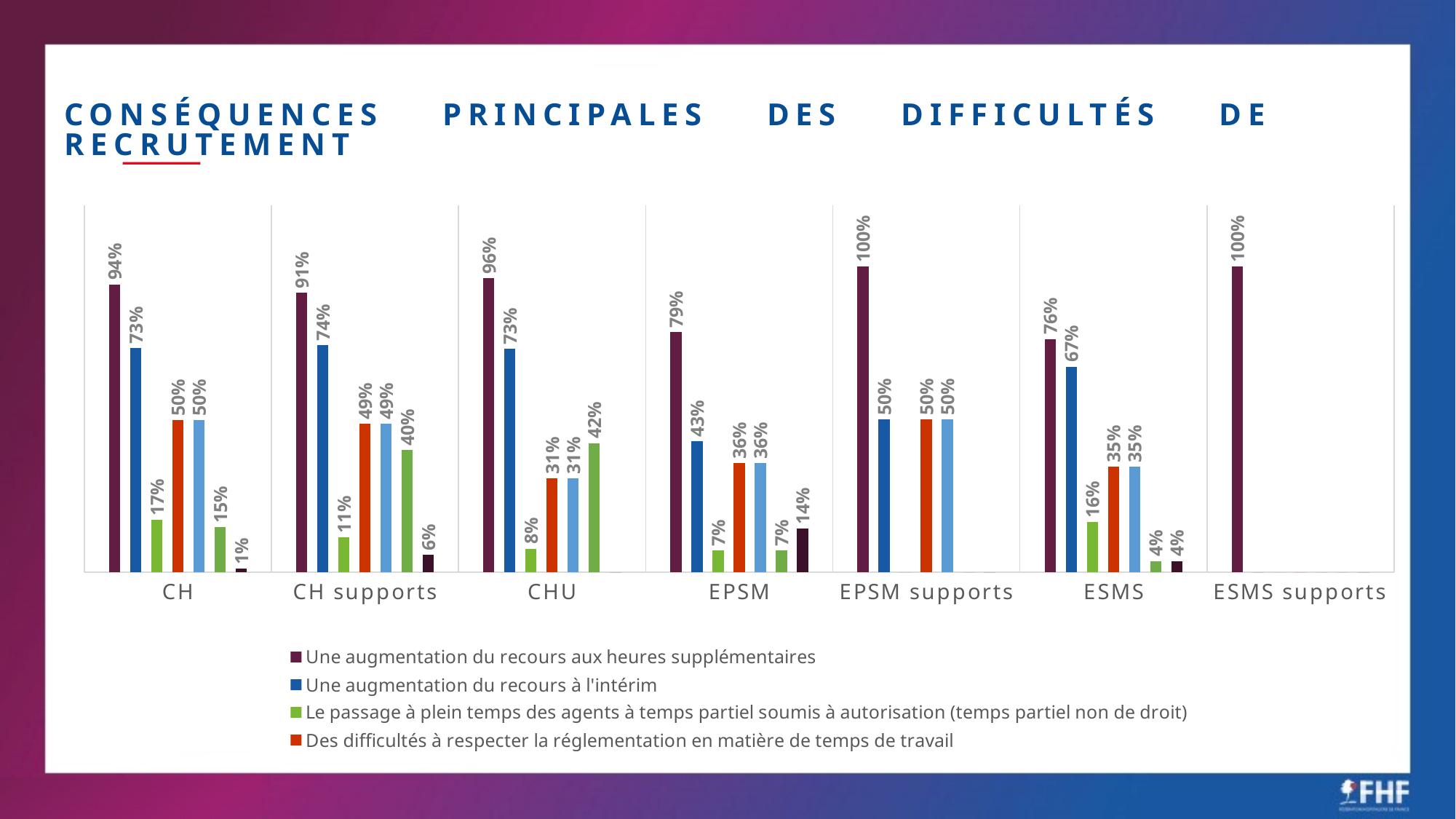
What is the value for 'Le passage à plein temps des agents à temps partiel soumis à autorisation (temps partiel non de droit)' for CHU? 8% How many categories are shown along the x axis? 7 What is the value for 'Une augmentation du recours aux heures supplémentaires' for CH? 94% What is the difference between the 'Une augmentation du recours aux heures supplémentaires' value and the 'Une augmentation du recours à l'intérim' value for EPSM? 36% How many series does the legend list? 4 What is the value for 'Une augmentation du recours à l'intérim' for ESMS? 67% Which category has the lowest value for 'Une augmentation du recours aux heures supplémentaires'? ESMS Which category has the highest value for 'Une augmentation du recours à l'intérim'? CH supports Which is larger for CH supports: 'Le passage à plein temps des agents à temps partiel soumis à autorisation (temps partiel non de droit)' or 'Des difficultés à respecter la réglementation en matière de temps de travail'? Des difficultés à respecter la réglementation en matière de temps de travail What is the value for 'Des difficultés à respecter la réglementation en matière de temps de travail' for EPSM? 36% What is the title of the chart on the slide? Conséquences principales des difficultés de recrutement What kind of chart is shown on the slide? bar chart